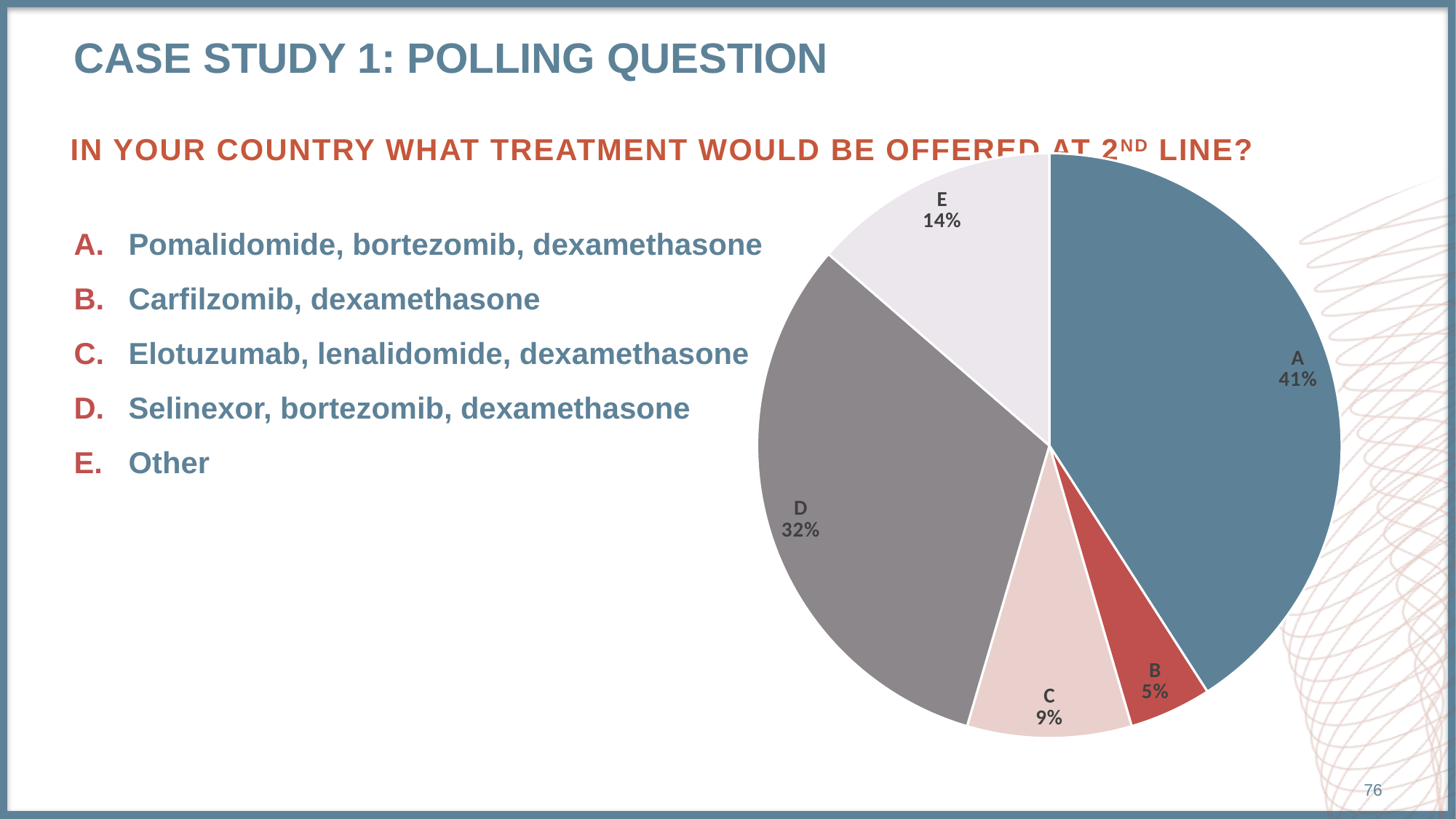
What type of chart is shown on the slide? pie chart What is the combined share of options B and C? 14% Which option has the largest share of the pie? A Which option's slice is coloured red? B How many slices does the pie chart have? 5 What percentage of the pie does option A represent? 41% What percentage of the pie does option D represent? 32% What percentage of the pie does option B represent? 5% What is the difference in percentage points between option A and option D? 9 What percentage of the pie does option E represent? 14% Which has a larger share, option C or option E? E Which option has the smallest share of the pie? B